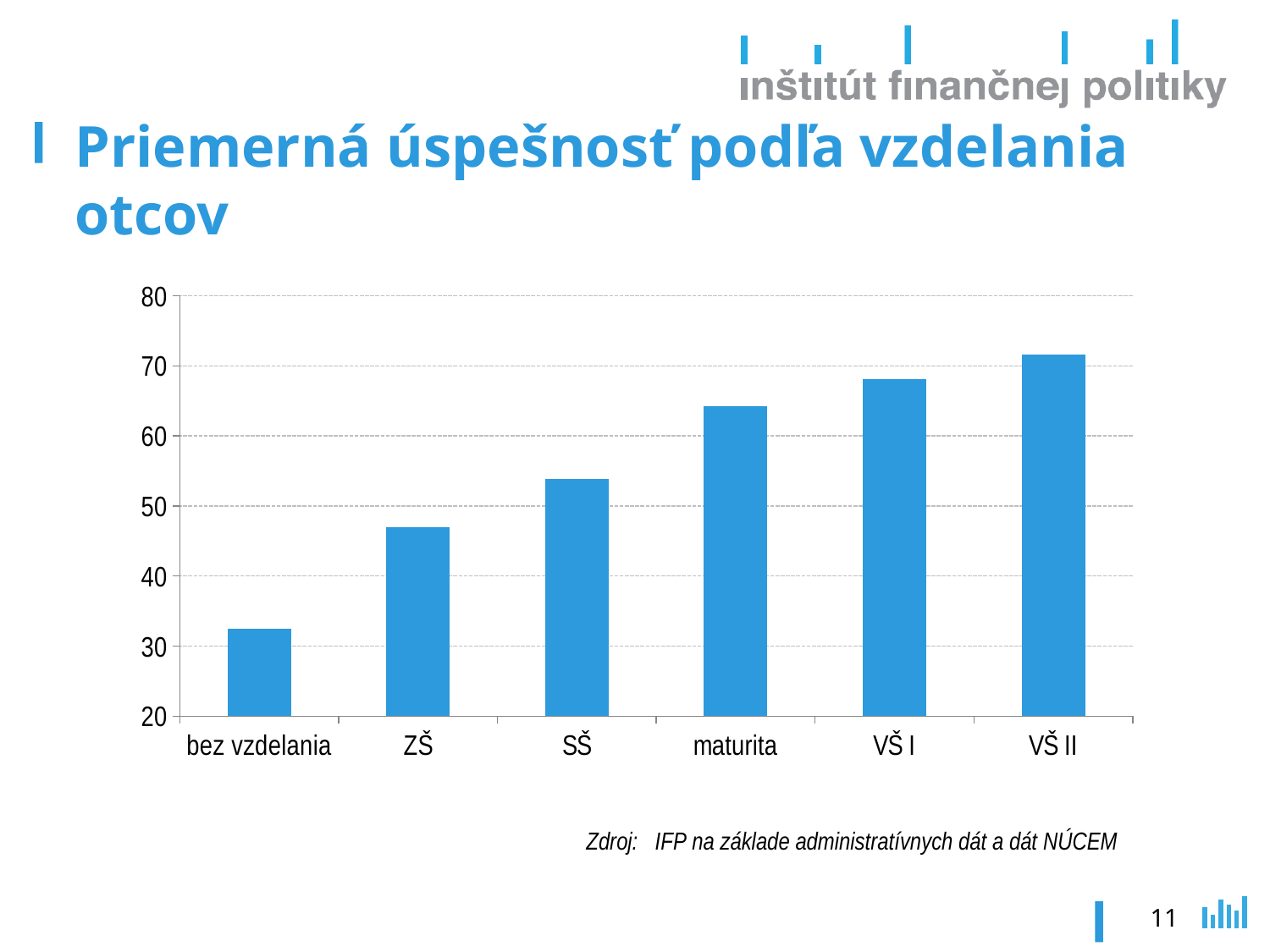
Is the value for VŠ II greater or less than 70? greater What kind of chart is shown on the slide? bar chart Which is larger, the value for ZŠ or the value for SŠ? SŠ Which is larger, the value for maturita or the value for VŠ I? VŠ I Is the value for maturita greater or less than 60? greater Do the values rise or fall from left to right along the x axis? rise Which category has the lowest value in the chart? bez vzdelania Is the value for bez vzdelania greater or less than 40? less Which category has the highest value in the chart? VŠ II How many categories are shown on the x axis of the chart? 6 What is the title of the slide containing the chart? Priemerná úspešnosť podľa vzdelania otcov